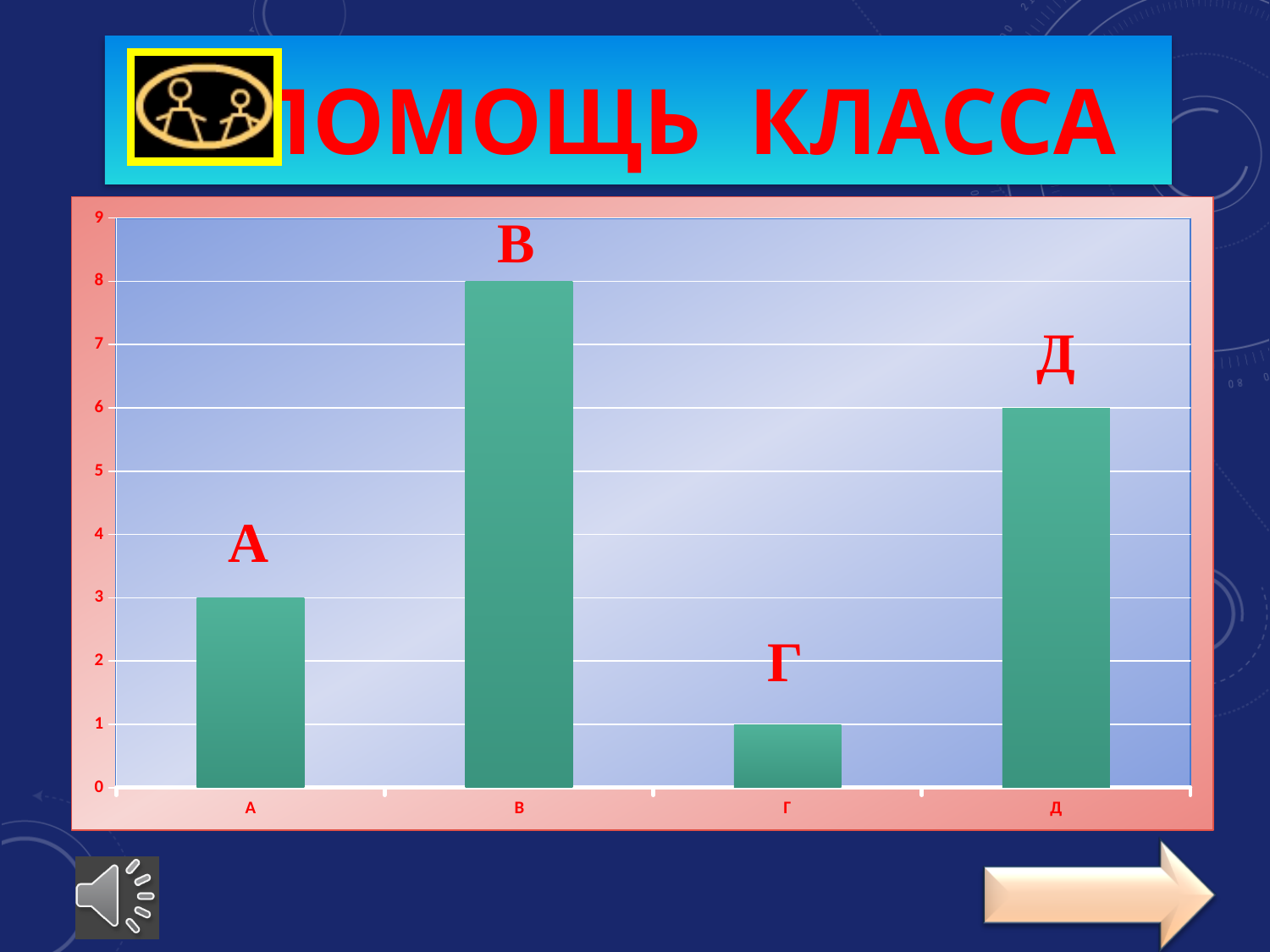
What is the value of the bar for category В? 8 What is the highest value shown on the vertical axis? 9 Which category has the highest bar? В What kind of chart is shown on the slide? bar chart What is the value of the bar for category Д? 6 Which is larger, the value for А or the value for Д? Д What is the difference between the values for В and Д? 2 Which category has the lowest bar? Г What is the value of the bar for category Г? 1 Is the value for В greater or less than 7? greater What is the value of the bar for category А? 3 How many categories are shown on the x axis? 4